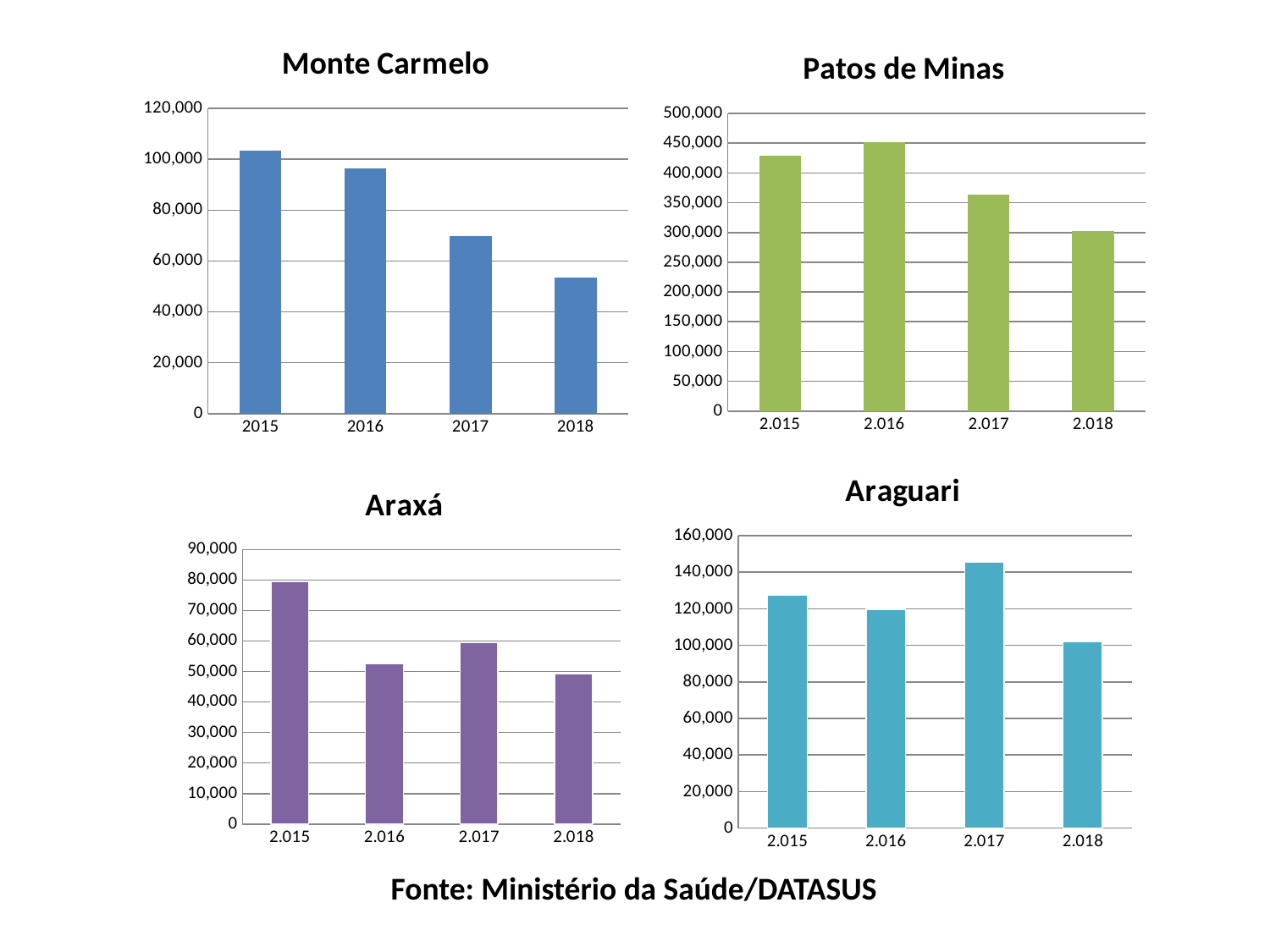
In the Monte Carmelo chart, is the value for 2018 greater or less than 60,000? less In the Monte Carmelo chart, which year has the highest value? 2015 In the Araxá chart, which year has the highest value? 2.015 In the Patos de Minas chart, which year has the highest value? 2.016 In the Monte Carmelo chart, do the values rise or fall from 2015 to 2018? fall In the Araguari chart, which year has the lowest value? 2.018 What kind of chart is the Monte Carmelo chart? bar chart In the Patos de Minas chart, is the value for 2.017 greater or less than 350,000? greater How many bars does the Araguari chart have? 4 In the Patos de Minas chart, which year has the lowest value? 2.018 In the Araxá chart, which is larger, the value for 2.016 or the value for 2.017? 2.017